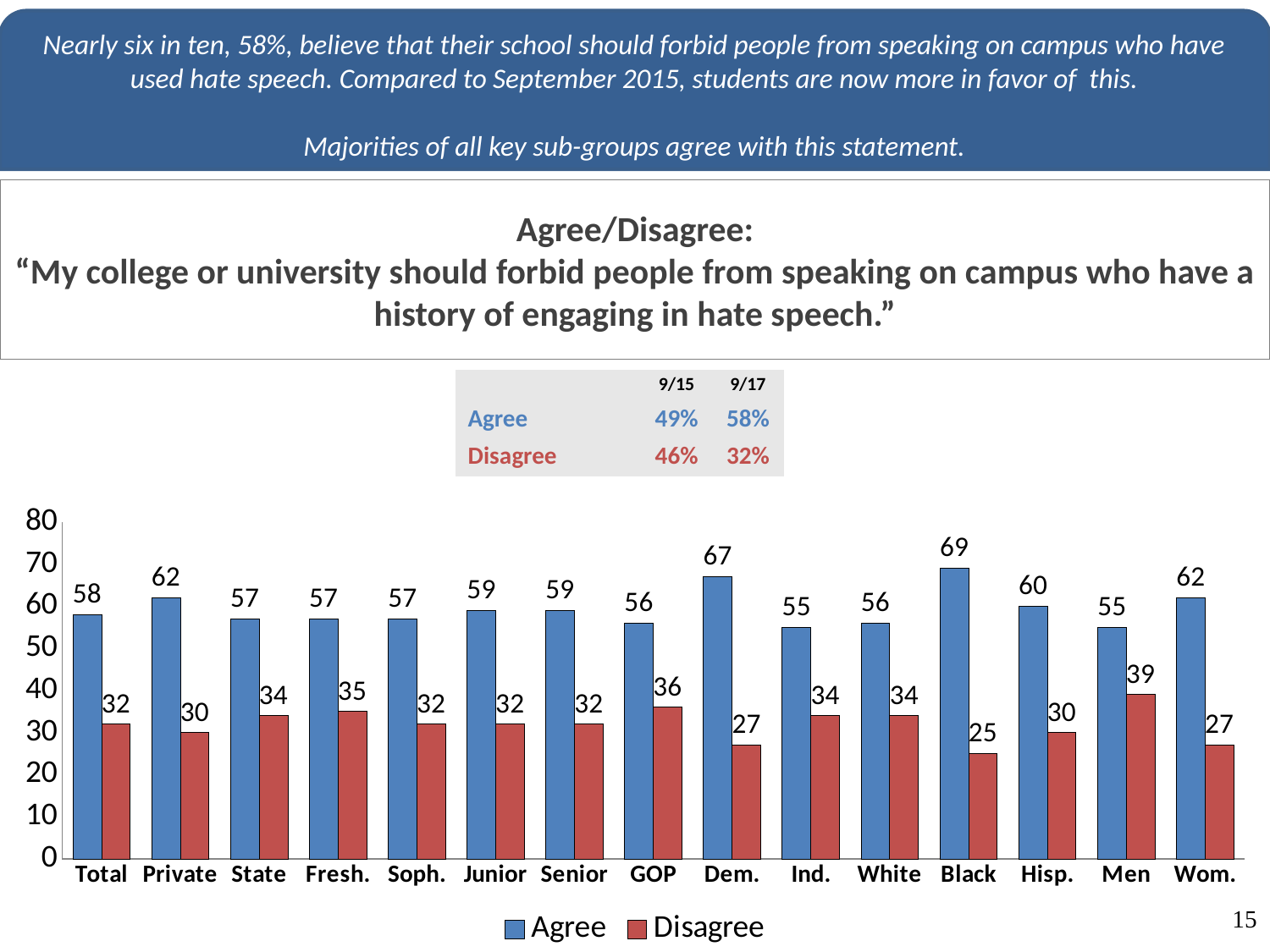
How many series does the legend list? 2 What is the difference between the Disagree values for GOP and Dem.? 9 Which category has the lowest Disagree value? Black What kind of chart is shown? bar chart What is the Agree value for Black? 69 What is the difference between the Agree and Disagree values for Dem.? 40 How many categories are shown on the x axis? 15 Which category has the highest Agree value? Black What colour are the Disagree bars? red What is the Disagree value for Men? 39 Which is larger, the Agree value for Private or the Agree value for State? Private What is the Agree value for Wom.? 62